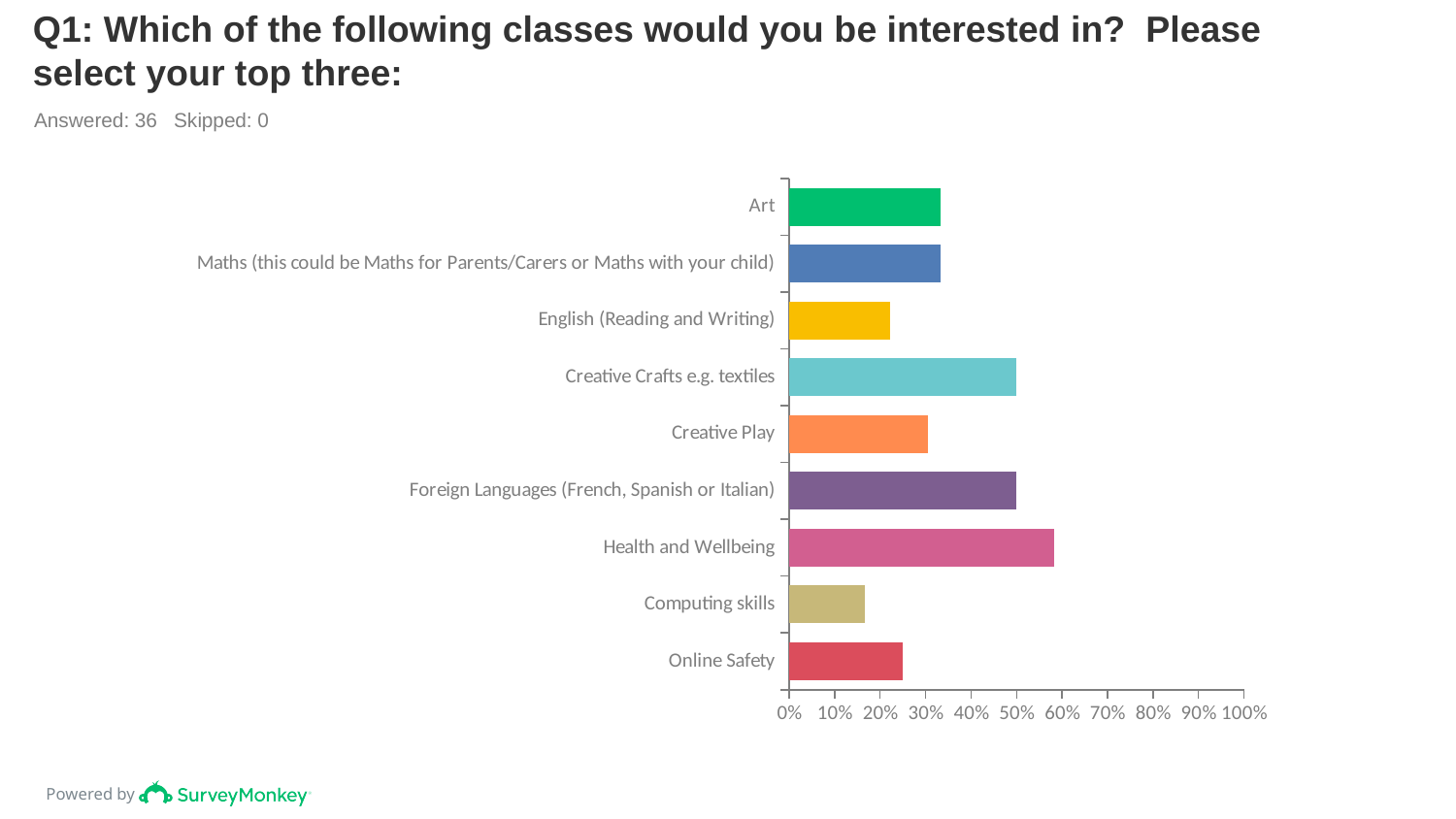
How many classes (categories) are shown in the chart? 9 Which class has the highest percentage of interest? Health and Wellbeing Is the value for Computing skills greater or less than 20%? less Is the value for Creative Play greater or less than 20%? greater What is the maximum value shown on the percentage axis? 100% Is the value for Online Safety greater or less than 30%? less What kind of chart is shown on the slide? bar chart Which has a larger value, Creative Crafts e.g. textiles or English (Reading and Writing)? Creative Crafts e.g. textiles Which has a larger value, Online Safety or Health and Wellbeing? Health and Wellbeing How many respondents answered the question according to the slide? 36 Which class has the lowest percentage of interest? Computing skills